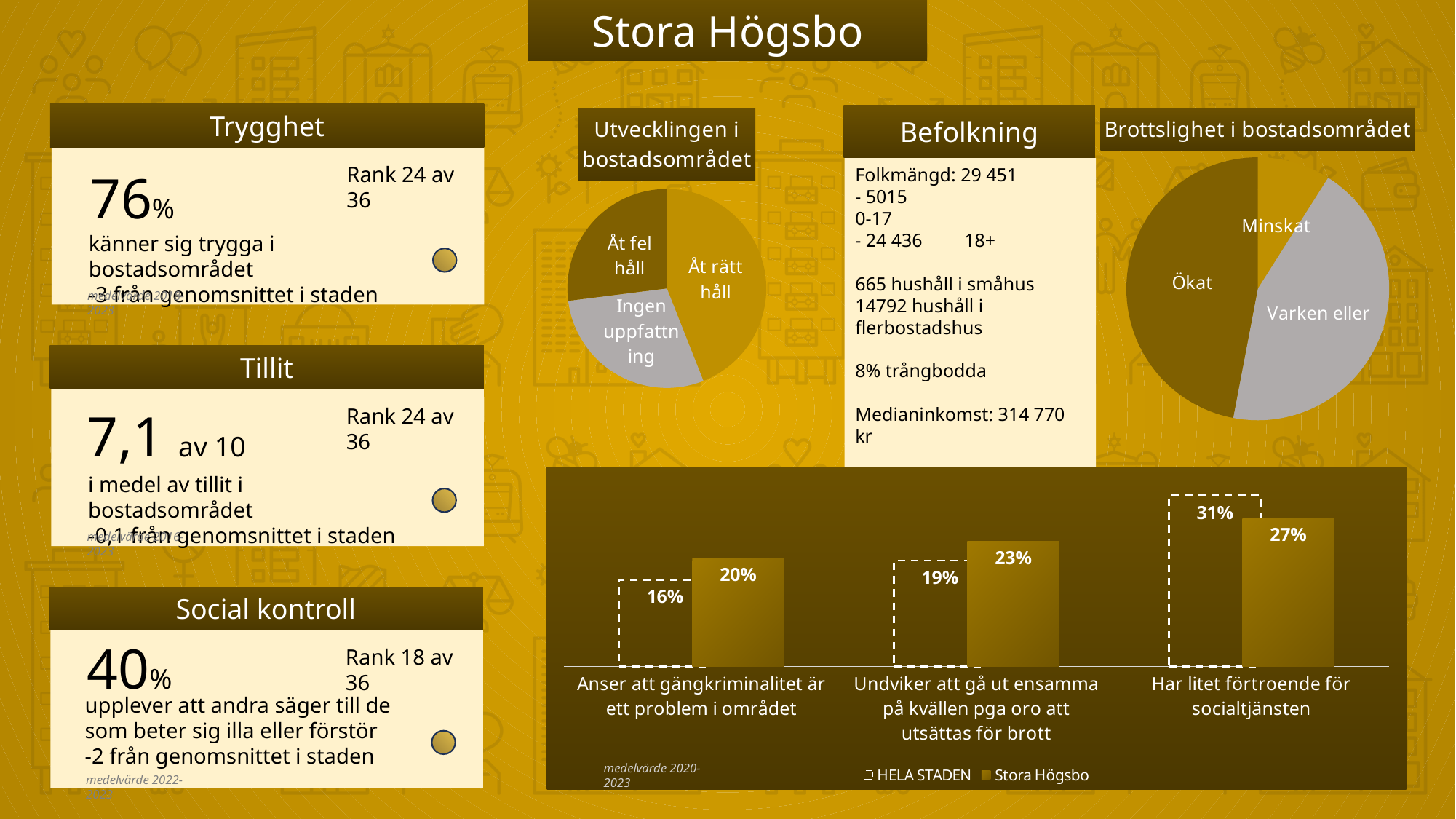
In the bar chart at the bottom, what is the value for HELA STADEN for 'Har litet förtroende för socialtjänsten'? 31% How many series does the legend of the bar chart at the bottom list? 2 In the 'Brottslighet i bostadsområdet' pie chart, which slice is the smallest? Minskat In the bar chart at the bottom, what is the value for Stora Högsbo for 'Undviker att gå ut ensamma på kvällen pga oro att utsättas för brott'? 23% In the bar chart at the bottom, which is larger for 'Har litet förtroende för socialtjänsten': HELA STADEN or Stora Högsbo? HELA STADEN How many slices does the 'Brottslighet i bostadsområdet' pie chart have? 3 In the bar chart at the bottom, what is the value for Stora Högsbo for 'Anser att gängkriminalitet är ett problem i området'? 20% In the bar chart at the bottom, which category has the highest value for Stora Högsbo? Har litet förtroende för socialtjänsten In the bar chart at the bottom, which category has the lowest value for HELA STADEN? Anser att gängkriminalitet är ett problem i området How many categories are shown in the bar chart at the bottom? 3 What kind of chart is 'Utvecklingen i bostadsområdet'? Pie chart In the bar chart at the bottom, what is the difference between HELA STADEN and Stora Högsbo for 'Anser att gängkriminalitet är ett problem i området'? 4%